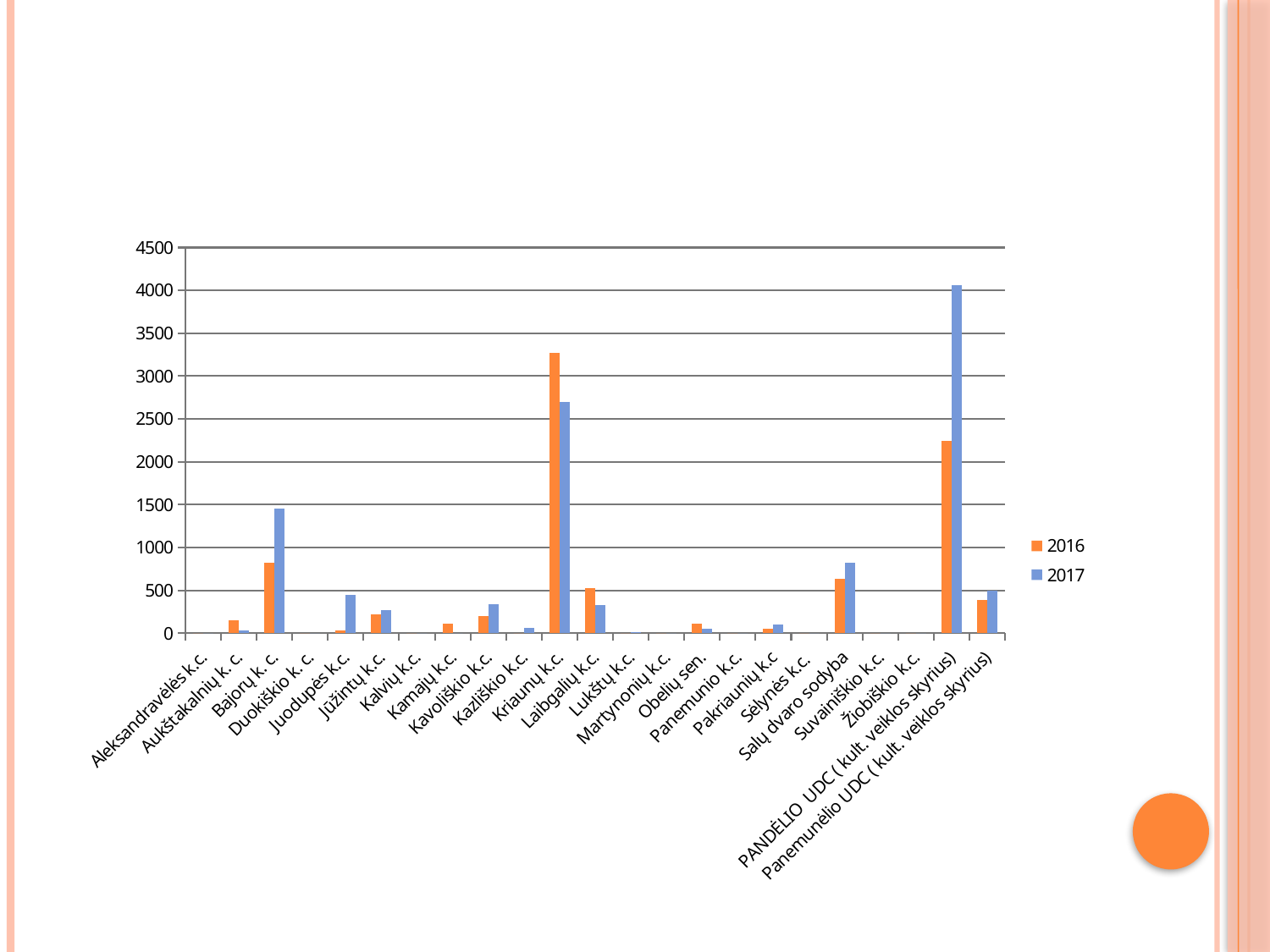
How many categories are shown on the x axis? 23 Is the 2017 value for PANDĖLIO UDC (kult. veiklos skyrius) greater or less than 3500? greater For Laibgalių k.c., which series has the larger value, 2016 or 2017? 2016 How many series does the legend list? 2 Which category has the highest value for 2016? Kriaunų k.c. For Kriaunų k.c., which series has the larger value, 2016 or 2017? 2016 Is the 2016 value for Kriaunų k.c. greater or less than 3000? greater Is the 2017 value for Bajorų k. c. greater or less than 1000? greater Which category has the highest value for 2017? PANDĖLIO UDC (kult. veiklos skyrius) What kind of chart is shown on the slide? bar chart For PANDĖLIO UDC (kult. veiklos skyrius), which series has the larger value, 2016 or 2017? 2017 Which series are listed in the legend? 2016 and 2017